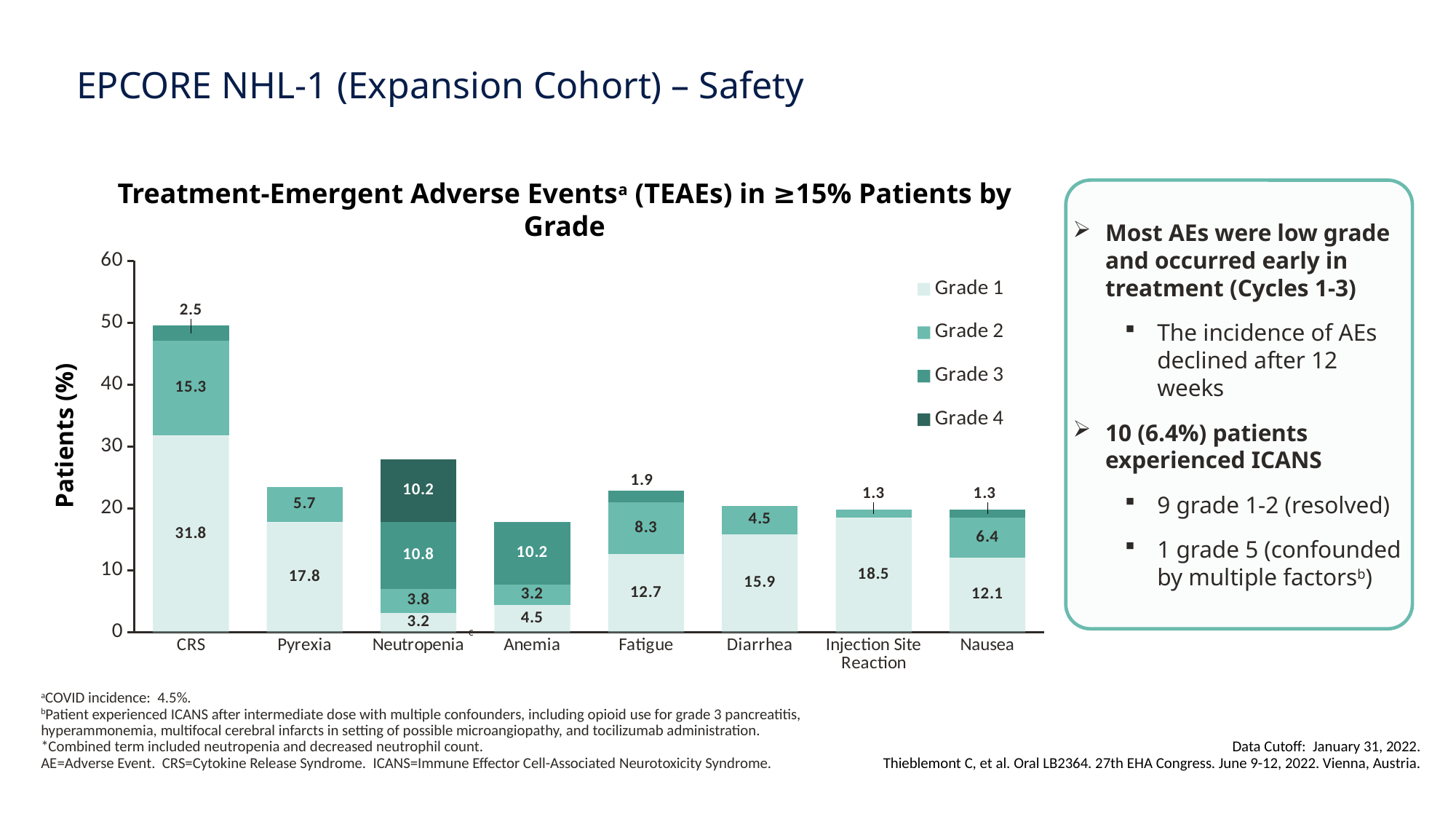
What is the Grade 1 value for CRS? 31.8 What is the Grade 1 value for Injection Site Reaction? 18.5 Which has the larger Grade 2 value, Fatigue or Nausea? Fatigue What is the total of the stacked bar for Neutropenia? 28.0 What kind of chart is shown? Stacked bar chart How many adverse event categories are shown on the x axis? 8 Is the total bar for CRS greater or less than 40? greater What is the Grade 2 value for Pyrexia? 5.7 How many series does the legend list? 4 Which adverse event has the highest total bar? CRS What is the Grade 4 value for Neutropenia? 10.2 What is the difference between the Grade 1 value for CRS and the Grade 1 value for Pyrexia? 14.0